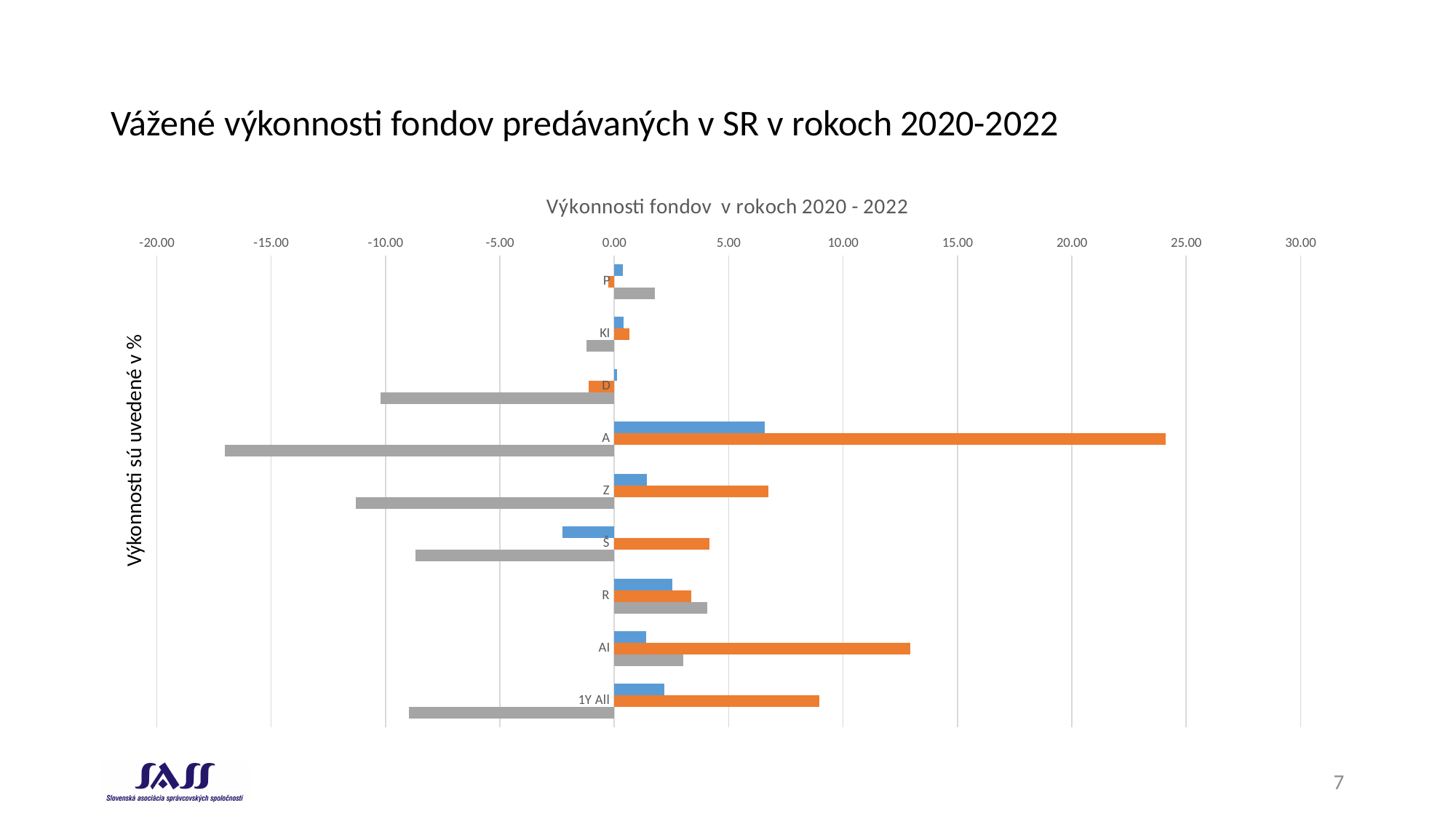
How many categories are shown on the vertical axis of the chart? 9 Which category has the highest blue bar? A Which is larger, the orange bar for Z or the orange bar for AI? AI Is the gray bar for 1Y All greater or less than -5.00? less Is the orange bar for A greater or less than 20.00? greater Which is larger, the blue bar for A or the blue bar for Z? A Is the orange bar for AI greater or less than 10.00? greater Which category has the lowest (most negative) gray bar? A What kind of chart is shown on the slide? bar chart What is the title of the chart? Výkonnosti fondov v rokoch 2020 - 2022 Which category has the longest orange bar? A